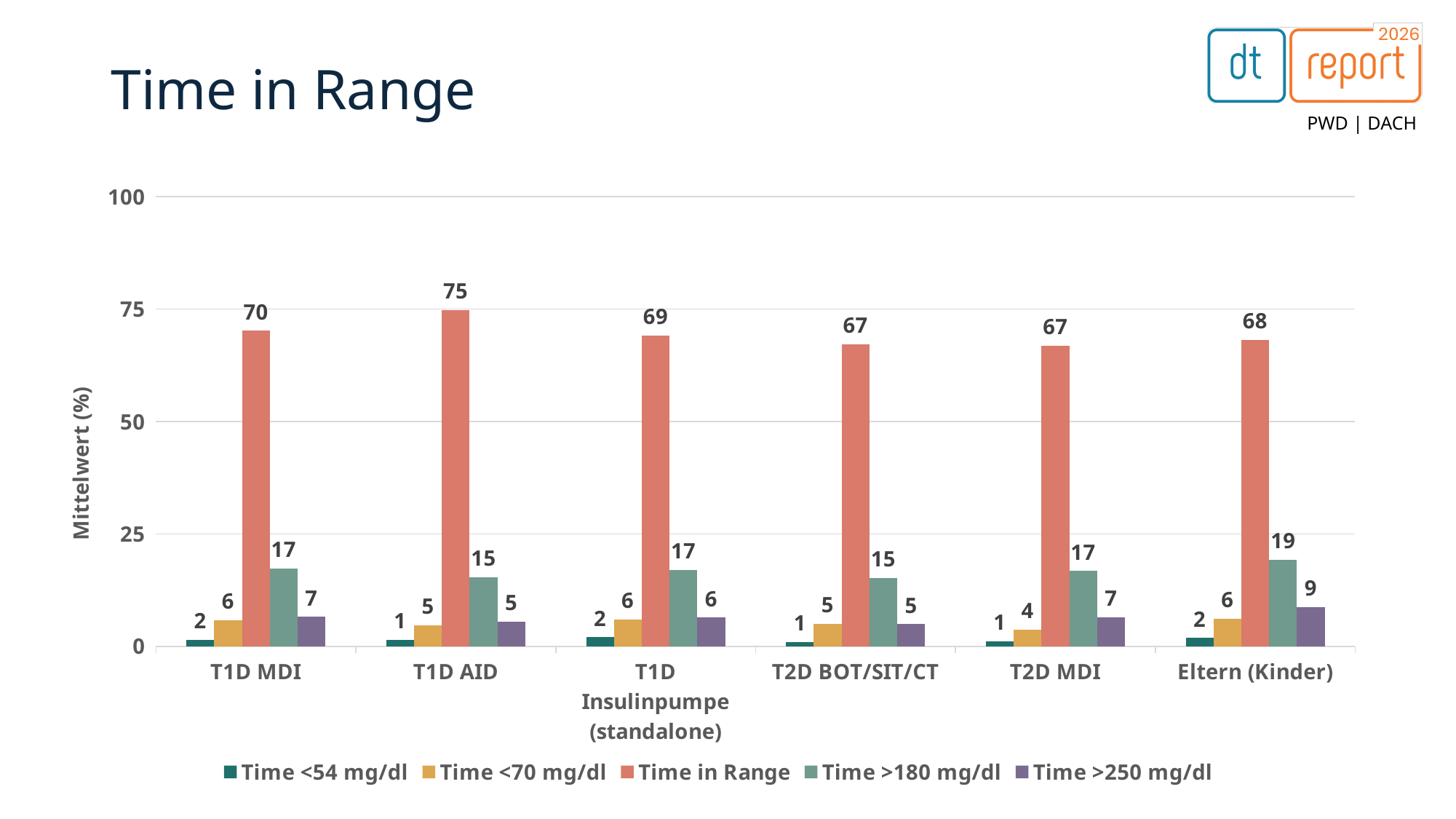
What is the Time >180 mg/dl value for Eltern (Kinder)? 19 Which is larger: the Time >180 mg/dl value for T1D MDI or for T1D AID? T1D MDI Is the Time in Range value for T2D BOT/SIT/CT greater or less than 75? less Which category has the highest Time >250 mg/dl value? Eltern (Kinder) Which category has the highest Time in Range value? T1D AID How many categories are shown on the x axis? 6 What is the Time in Range value for T1D AID? 75 How many series does the legend list? 5 What is the difference between the Time in Range values for T1D AID and T1D MDI? 5 What is the label of the y axis? Mittelwert (%) What kind of chart is shown on the slide? bar chart What is the Time <70 mg/dl value for T2D MDI? 4